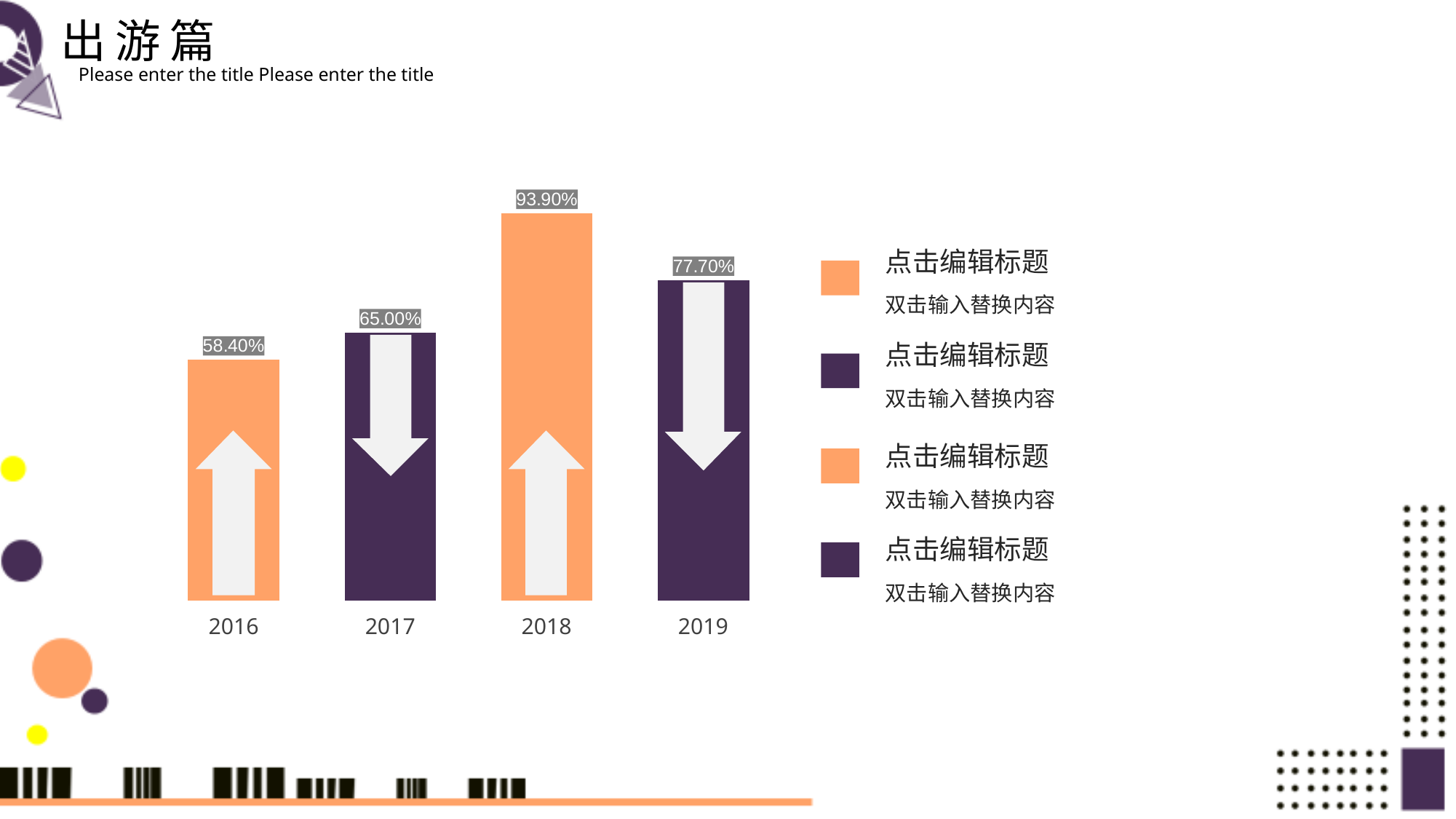
What is the value for 2016? 58.40% What is the difference between the values for 2018 and 2019? 16.20% Which is larger, the value for 2019 or the value for 2017? 2019 What is the value for 2017? 65.00% Which year has the highest value? 2018 What is the difference between the values for 2017 and 2016? 6.60% What is the value for 2018? 93.90% What is the value for 2019? 77.70% What kind of chart is shown on the slide? bar chart How many years are shown on the x axis? 4 Which year has the lowest value? 2016 What colour is the bar for 2018? orange